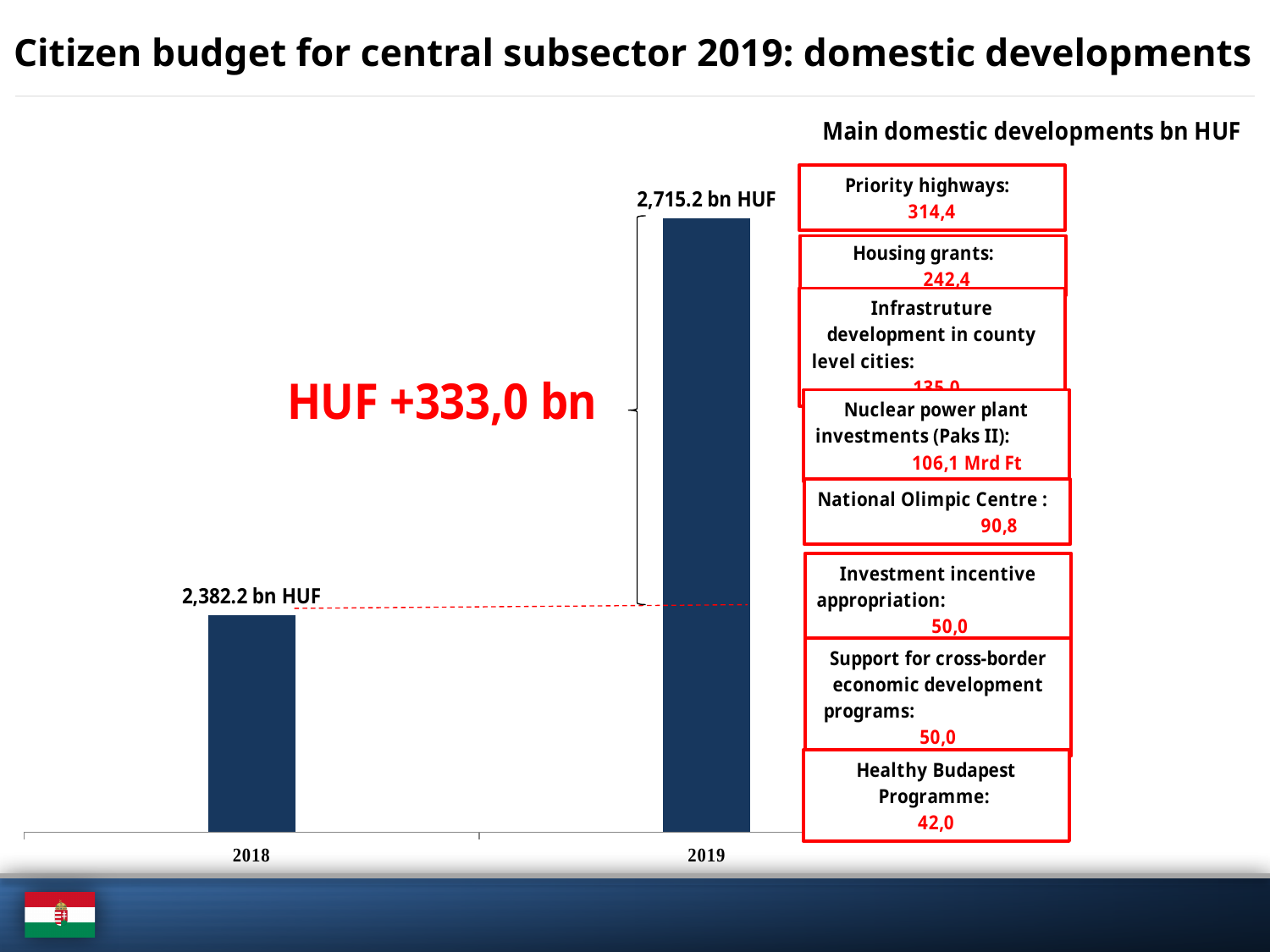
What is the title of the slide containing the chart? Citizen budget for central subsector 2019: domestic developments What is the difference between the 2019 and 2018 values, as labelled on the chart? HUF +333,0 bn Which year has the higher bar, 2018 or 2019? 2019 According to the boxes beside the chart, what is the amount for Priority highways? 314,4 What kind of chart is shown on the slide? Bar chart What is the value of the bar for 2019? 2,715.2 bn HUF What is the value of the bar for 2018? 2,382.2 bn HUF Which year has the lowest value in the chart? 2018 What colour are the bars in the chart? Dark blue According to the boxes beside the chart, what is the amount for Housing grants? 242,4 Do the values rise or fall from 2018 to 2019? Rise How many bars are shown in the chart? 2